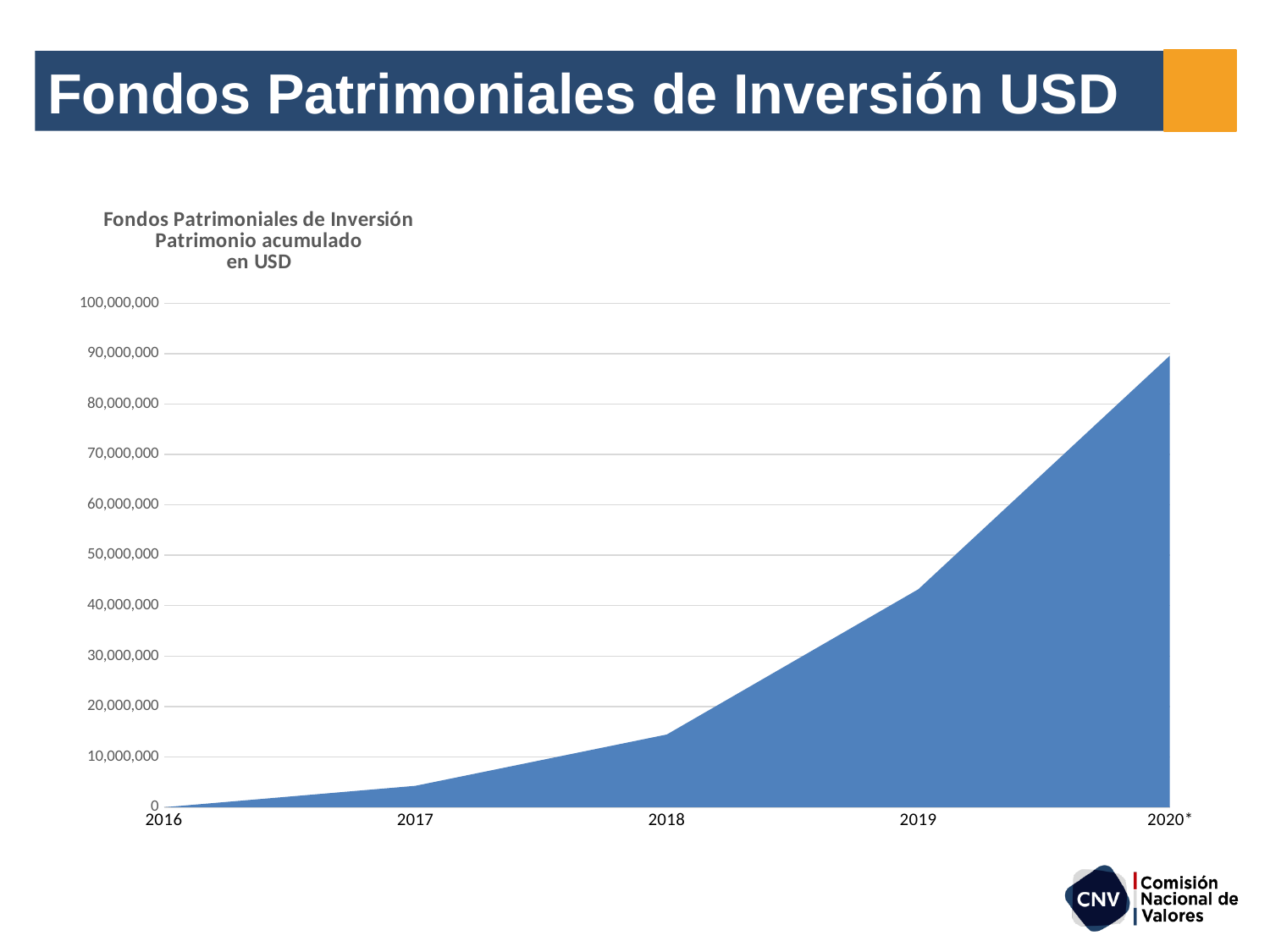
Is the value for 2020* greater or less than 80,000,000? greater Is the value for 2019 greater or less than 40,000,000? greater Is the value for 2018 greater or less than 10,000,000? greater Which year has the lowest accumulated value? 2016 Which year has the highest accumulated value? 2020* What is the title of the chart? Fondos Patrimoniales de Inversión Patrimonio acumulado en USD Do the values rise or fall from 2016 to 2020*? rise Which is larger, the value for 2019 or the value for 2018? 2019 How many years are plotted along the x axis? 5 What is the highest value shown on the y axis? 100,000,000 What kind of chart is shown on the slide? area chart